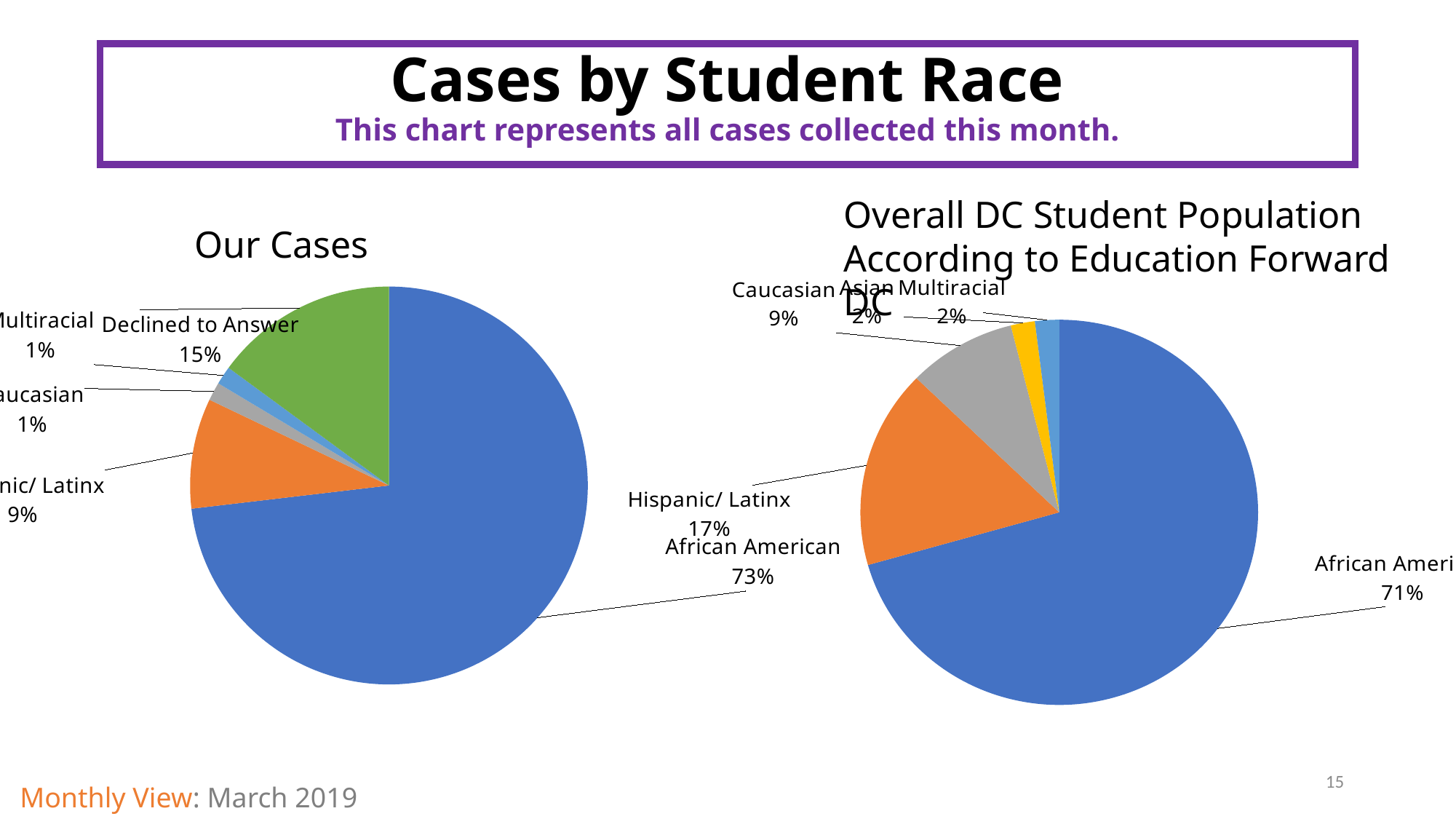
What is the difference between the Declined to Answer share and the Hispanic/ Latinx share in the Our Cases chart? 6 percentage points What type of chart is used for Our Cases? Pie chart In the Overall DC Student Population chart, what percentage is Caucasian? 9% In the Our Cases pie chart, what percentage of cases is Declined to Answer? 15% Which is larger: the African American share in Our Cases or in the Overall DC Student Population chart? Our Cases In the Overall DC Student Population chart, which category has the largest share? African American In the Our Cases pie chart, what share of cases is African American? 73% How many categories are shown in the Overall DC Student Population pie chart? 5 In the Overall DC Student Population chart, what percentage is Asian? 2% In the Overall DC Student Population chart, what share is Hispanic/ Latinx? 17% In the Our Cases pie chart, which category has the largest share? African American What is the difference between the Hispanic/ Latinx share in the Overall DC Student Population chart and in the Our Cases chart? 8 percentage points